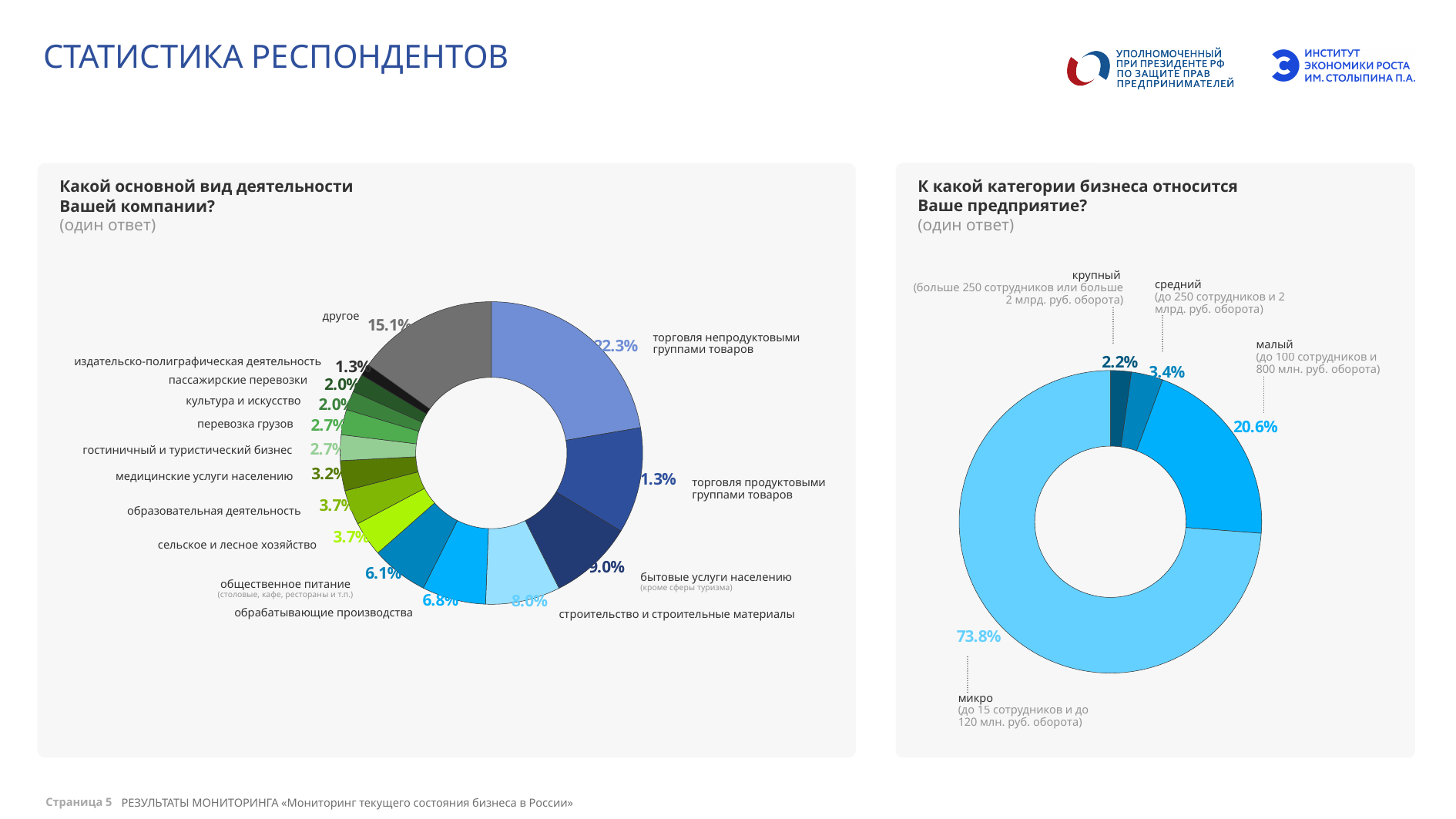
On the left chart, what is the value for строительство и строительные материалы? 8.0% On the left chart, which is larger: обрабатывающие производства or общественное питание? обрабатывающие производства On the right chart, what is the value for малый (small business)? 20.6% What type of chart is used on the right side of the slide? Donut (pie) chart On the right chart, what is the difference between the shares of малый and средний? 17.2% On the right chart, which business category has the smallest share? крупный On the right chart, how many business categories are shown? 4 On the right chart (К какой категории бизнеса относится Ваше предприятие?), what share of respondents are micro businesses (микро)? 73.8% On the left chart, which activity has the smallest share? издательско-полиграфическая деятельность On the left chart, what is the value for другое? 15.1% On the left chart (Какой основной вид деятельности Вашей компании?), what is the value for торговля непродуктовыми группами товаров? 22.3% On the right chart, what is the value for крупный (large business)? 2.2%